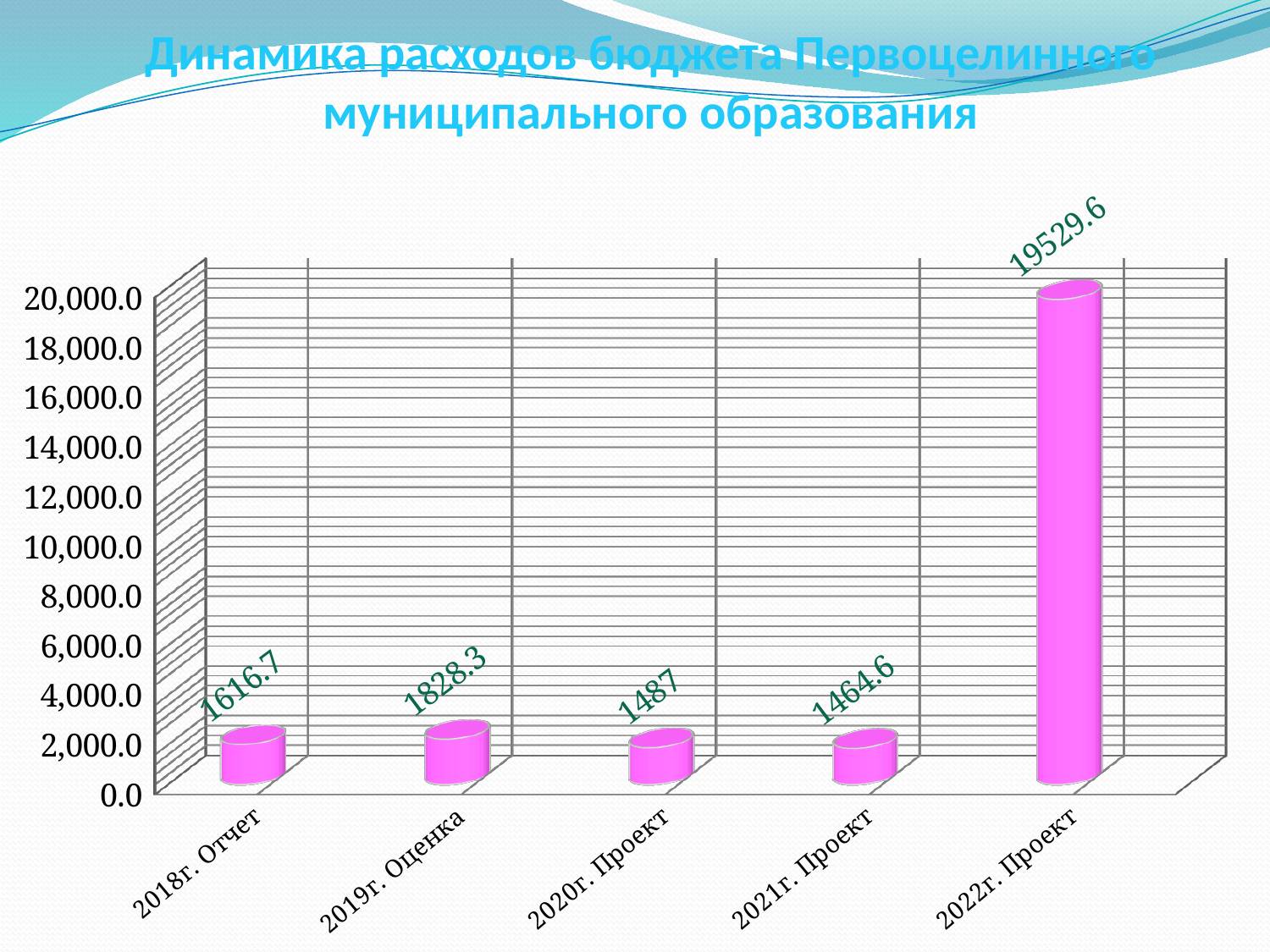
What is the value for 2022г. Проект? 19529.6 What is the difference between the values for 2022г. Проект and 2019г. Оценка? 17701.3 What is the value for 2021г. Проект? 1464.6 Which is larger, the value for 2018г. Отчет or the value for 2019г. Оценка? 2019г. Оценка What is the value for 2018г. Отчет? 1616.7 Which category has the highest value? 2022г. Проект How many categories are shown on the x axis? 5 What is the value for 2020г. Проект? 1487 What kind of chart is shown on the slide? bar chart What is the value for 2019г. Оценка? 1828.3 Is the value for 2022г. Проект greater or less than 18,000.0? greater Which category has the lowest value? 2021г. Проект